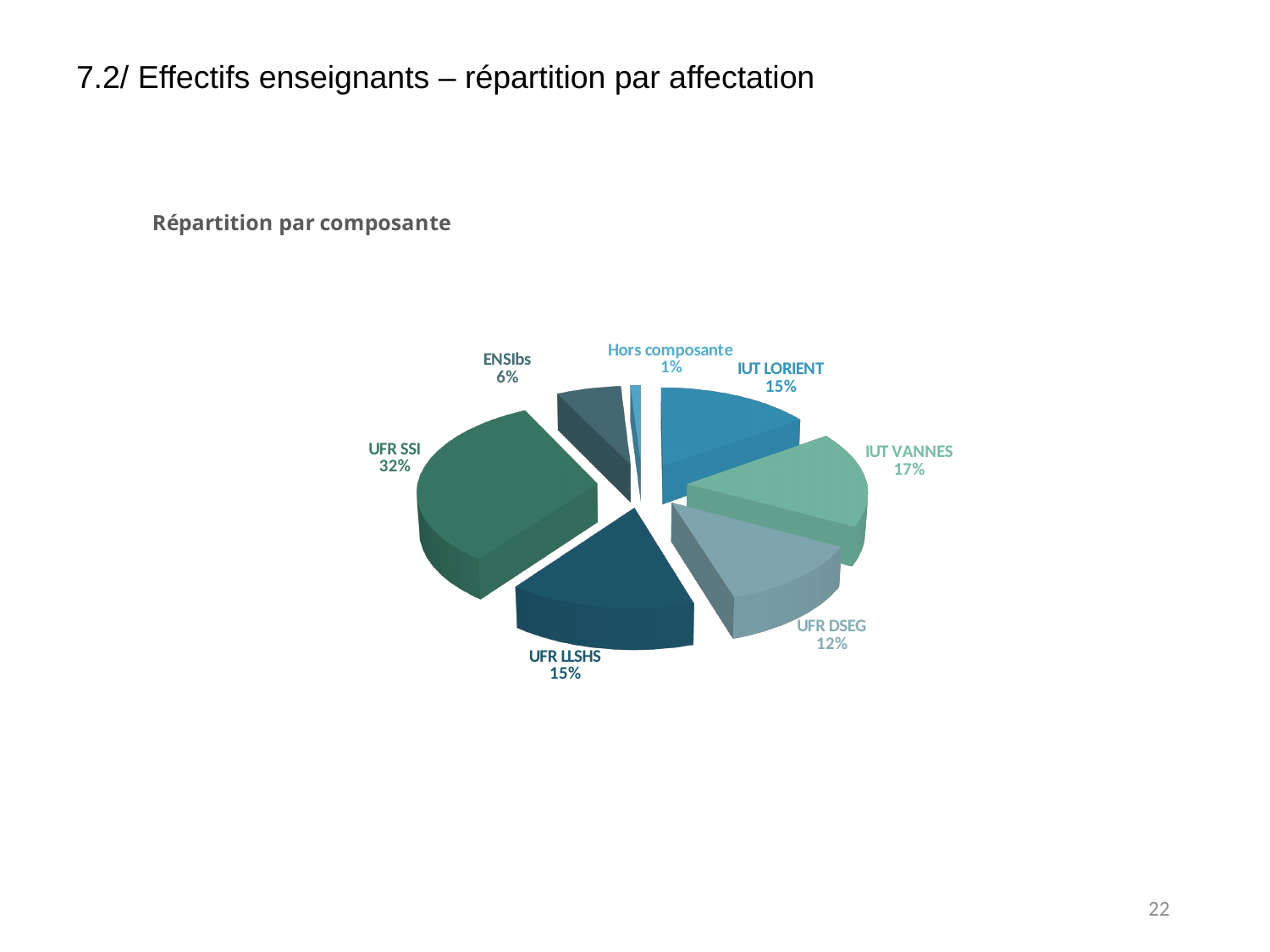
What share of the pie does UFR SSI represent? 32% What is the value shown for IUT VANNES? 17% Which category has the smallest share of the pie? Hors composante What is the title of the chart? Répartition par composante What is the difference between the shares of ENSIbs and Hors composante? 5% How many categories are shown in the pie chart? 7 What is the value shown for UFR DSEG? 12% What kind of chart is shown on the slide? Pie chart Which is larger, the share for IUT VANNES or the share for UFR DSEG? IUT VANNES What is the value shown for ENSIbs? 6% Which category has the largest share of the pie? UFR SSI What is the difference between the shares of UFR SSI and IUT VANNES? 15%